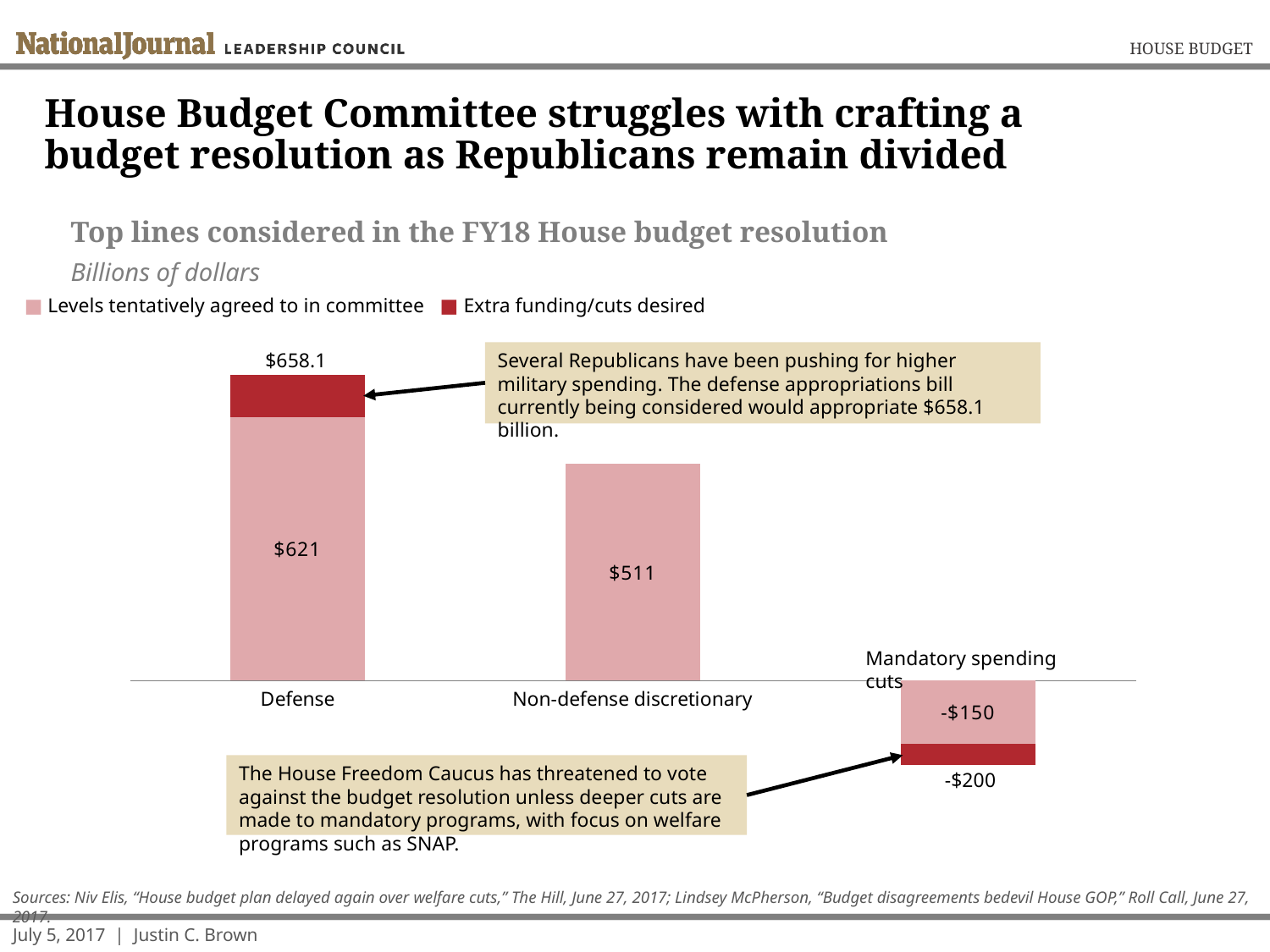
How many categories are shown on the x axis of the chart? 3 How many series does the chart's legend list? 2 What is the level tentatively agreed to in committee for Mandatory spending cuts? -$150 What is the total value labeled for Mandatory spending cuts, including the extra cuts desired? -$200 What is the difference between the Defense total of $658.1 and the committee-agreed Defense level of $621? $37.1 What is the level tentatively agreed to in committee for Defense? $621 What is the total value labeled at the top of the Defense bar, including extra funding desired? $658.1 What is the level tentatively agreed to in committee for Non-defense discretionary? $511 Which category has the highest level tentatively agreed to in committee? Defense What kind of chart is shown on the slide? Stacked bar chart Which category has the lowest value in the chart? Mandatory spending cuts Which is larger, the committee-agreed level for Defense or for Non-defense discretionary? Defense